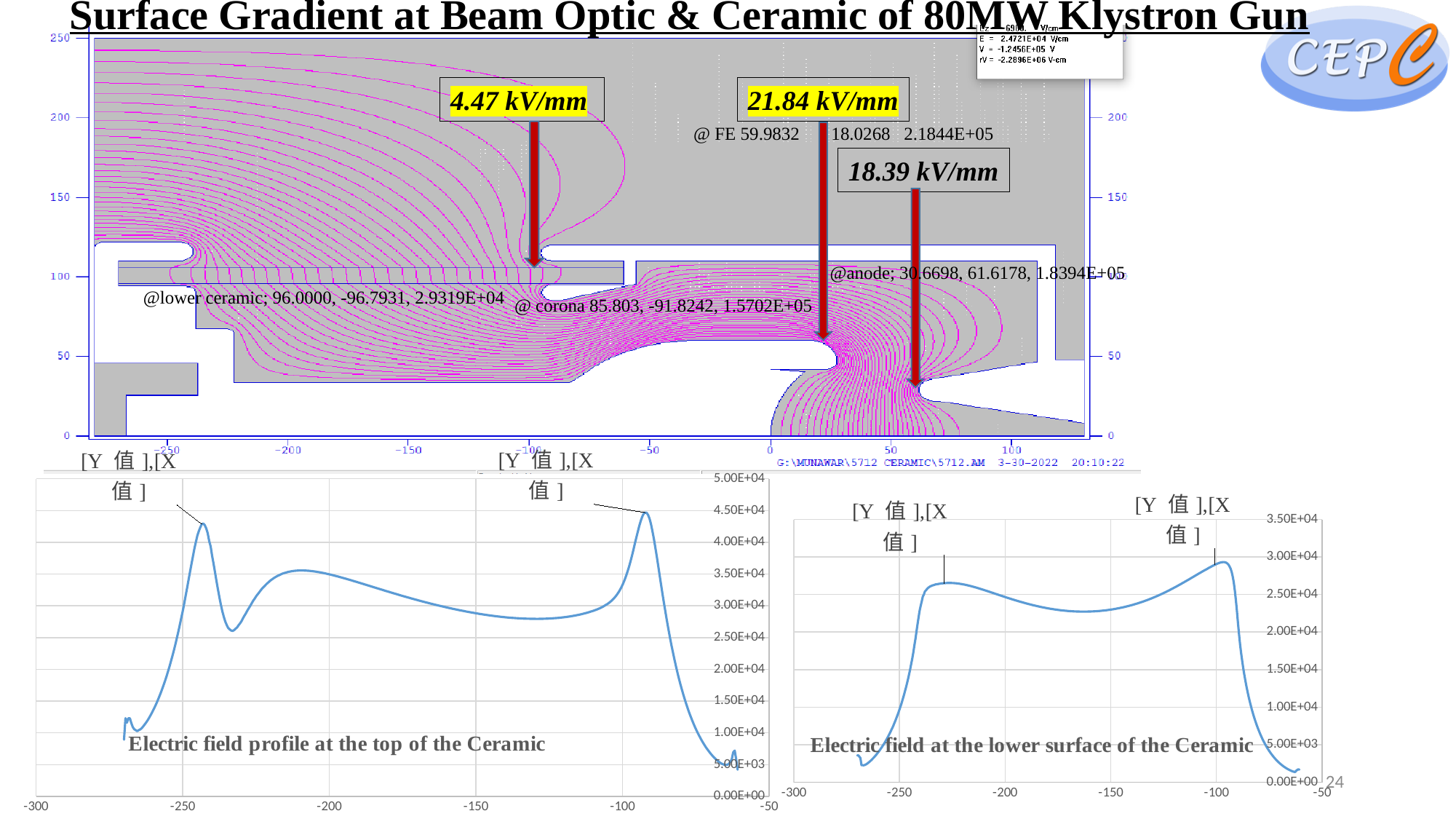
What is the maximum value shown on the y axis of the 'Electric field at the lower surface of the Ceramic' chart? 3.50E+04 What kind of chart is the 'Electric field profile at the top of the Ceramic' chart? line chart Of the three surface gradient values labelled on the field map at the top of the slide, which is the highest? 21.84 kV/mm In the 'Electric field profile at the top of the Ceramic' chart, is the value at the right end of the curve (near x = -60) greater or less than 1.00E+04? less In the 'Electric field at the lower surface of the Ceramic' chart, is the value at the right end of the curve (near x = -60) greater or less than 5.00E+03? less How many line charts are shown at the bottom of the slide? 2 In the 'Electric field at the lower surface of the Ceramic' chart, is the peak value near x = -100 greater or less than 2.50E+04? greater What kind of chart is the 'Electric field at the lower surface of the Ceramic' chart? line chart In the 'Electric field profile at the top of the Ceramic' chart, how many lines are plotted? 1 In the 'Electric field profile at the top of the Ceramic' chart, does the curve rise or fall between x = -100 and x = -60? fall In the 'Electric field at the lower surface of the Ceramic' chart, which peak is higher: the one near x = -230 or the one near x = -100? the one near x = -100